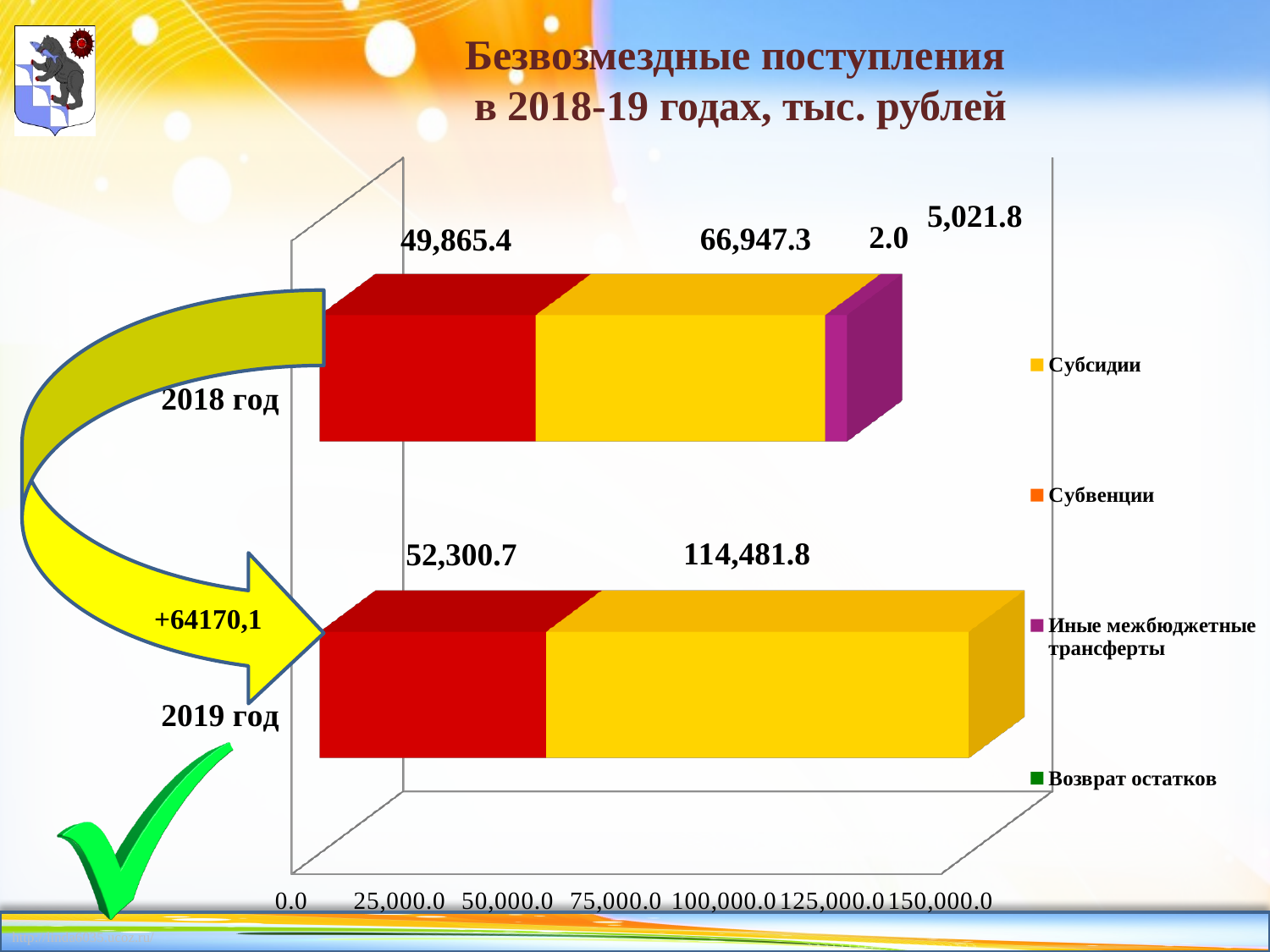
How many bars (years) are plotted in the chart? 2 What is the value of the yellow segment of the 2018 год bar? 66,947.3 Which bar has the larger yellow segment, 2018 год or 2019 год? 2019 год What is the title of the chart? Безвозмездные поступления в 2018-19 годах, тыс. рублей What is the value of the red segment of the 2018 год bar? 49,865.4 Is the total length of the 2019 год bar greater or less than 125,000.0? greater What is the value of the yellow segment of the 2019 год bar? 114,481.8 How many series does the legend list? 4 What kind of chart is shown on the slide? bar chart What is the value of the red segment of the 2019 год bar? 52,300.7 What is the difference between the yellow and red segments of the 2019 год bar? 62,181.1 What is the difference between the yellow segment of the 2019 год bar and the yellow segment of the 2018 год bar? 47,534.5